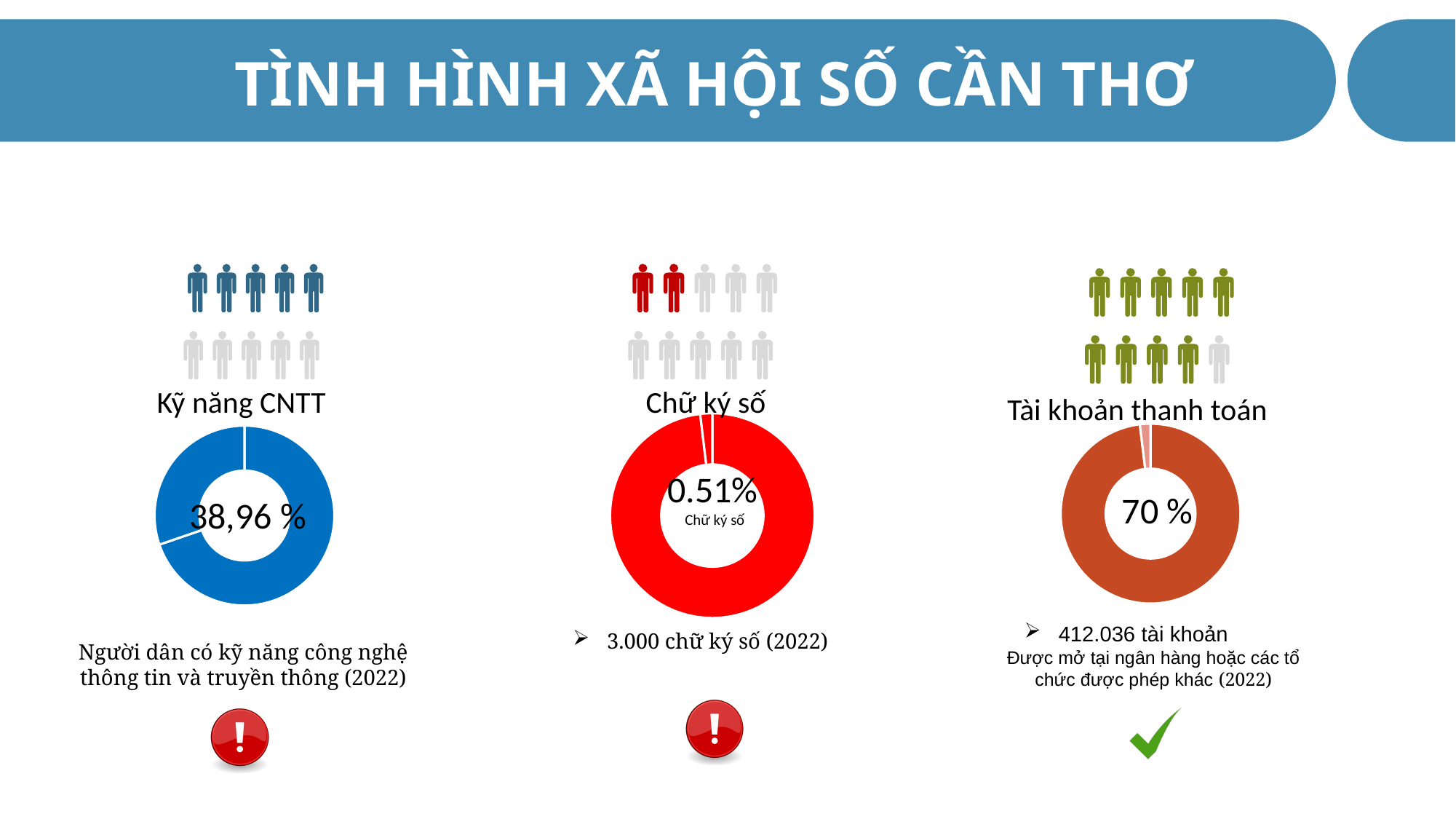
Which is larger, the percentage on the 'Kỹ năng CNTT' chart or the percentage on the 'Tài khoản thanh toán' chart? Tài khoản thanh toán Which of the three donut charts shows the lowest percentage? Chữ ký số On the 'Kỹ năng CNTT' chart, what percentage is shown in the centre of the donut? 38,96 % On the 'Tài khoản thanh toán' chart, what percentage is shown in the centre of the donut? 70 % Below the 'Chữ ký số' chart, how many digital signatures are reported for 2022? 3.000 Which of the three donut charts shows the highest percentage? Tài khoản thanh toán What colour is the 'Kỹ năng CNTT' donut chart? blue Below the 'Tài khoản thanh toán' chart, how many accounts are reported? 412.036 On the 'Chữ ký số' chart, what percentage is shown in the centre of the donut? 0.51% How many donut charts are on the slide? 3 What colour is the 'Chữ ký số' donut chart? red What kind of chart is used for 'Kỹ năng CNTT', 'Chữ ký số' and 'Tài khoản thanh toán'? donut chart